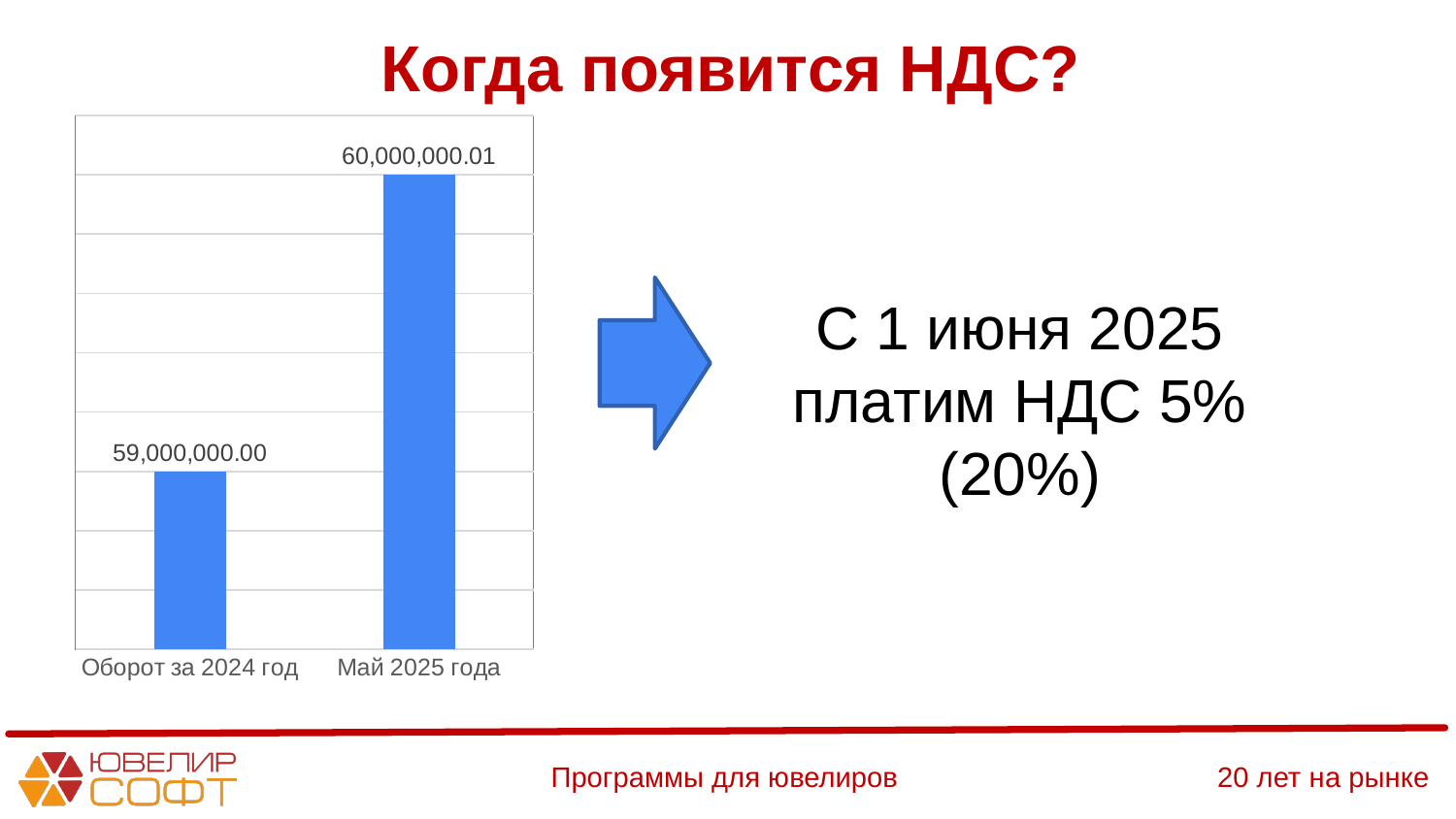
What is the value for Май 2025 года? 60,000,000.01 What colour are the bars in the chart? Blue Which category has the lowest value? Оборот за 2024 год Which is larger: the value for Оборот за 2024 год or the value for Май 2025 года? Май 2025 года How many categories are shown in the chart? 2 What kind of chart is shown on the slide? Bar chart Do the values rise or fall from Оборот за 2024 год to Май 2025 года? Rise What is the difference between the value for Май 2025 года and the value for Оборот за 2024 год? 1,000,000.01 What is the value for Оборот за 2024 год? 59,000,000.00 Which category has the highest value? Май 2025 года What is the label of the first category on the x axis? Оборот за 2024 год